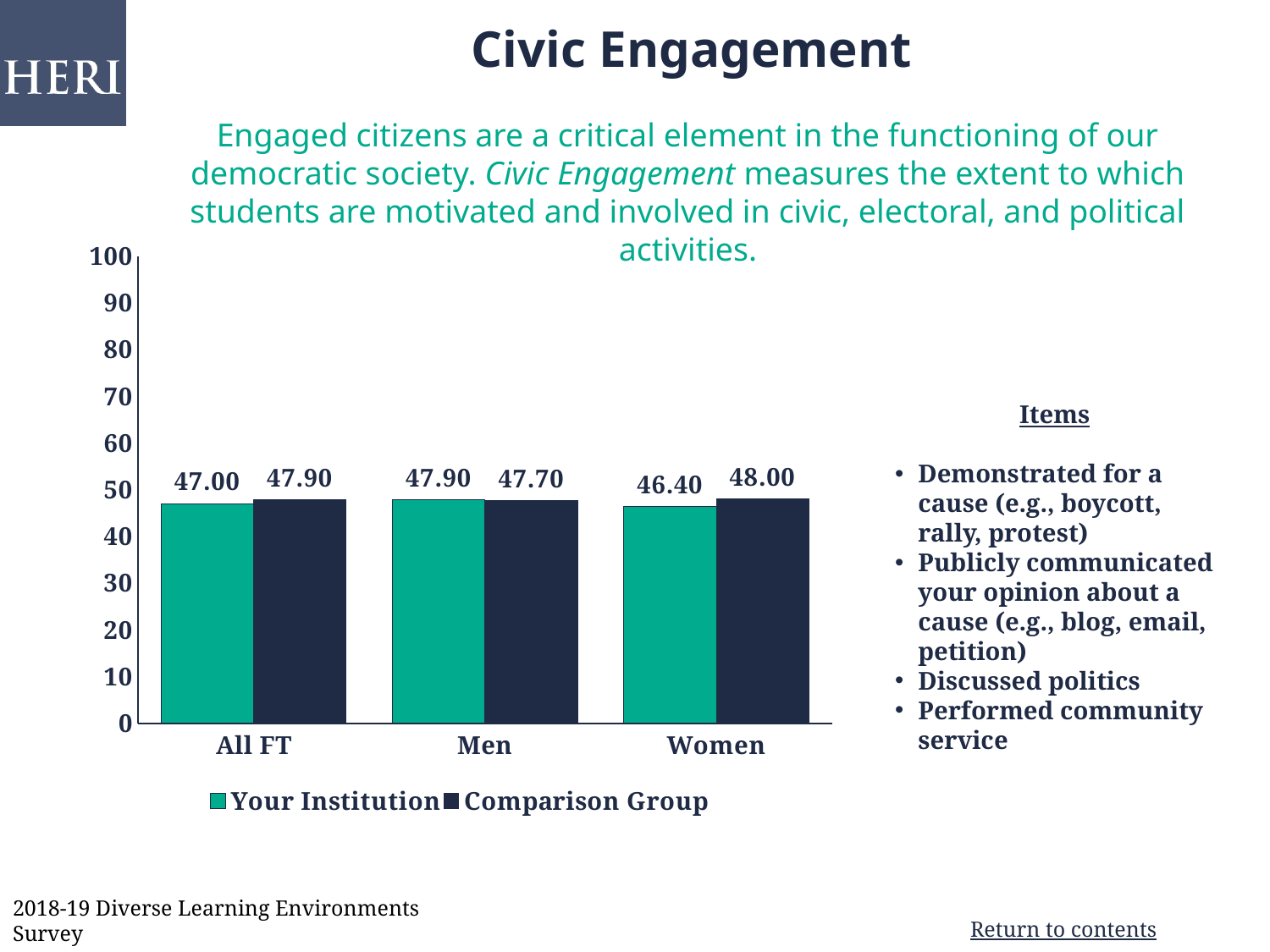
What is the difference between the Comparison Group and Your Institution values in the All FT category? 0.90 What is the value for Comparison Group in the Women category? 48.00 What is the value for Your Institution in the All FT category? 47.00 What kind of chart is shown on the slide? bar chart Is the value for Your Institution in the Women category greater or less than 50? less What is the value for Comparison Group in the Men category? 47.70 In the Women category, which series has the larger value, Your Institution or Comparison Group? Comparison Group What is the difference between the Comparison Group and Your Institution values in the Women category? 1.60 What is the value for Your Institution in the Men category? 47.90 How many series does the legend list? 2 Which category has the lowest value for Your Institution? Women How many categories are shown on the x axis? 3